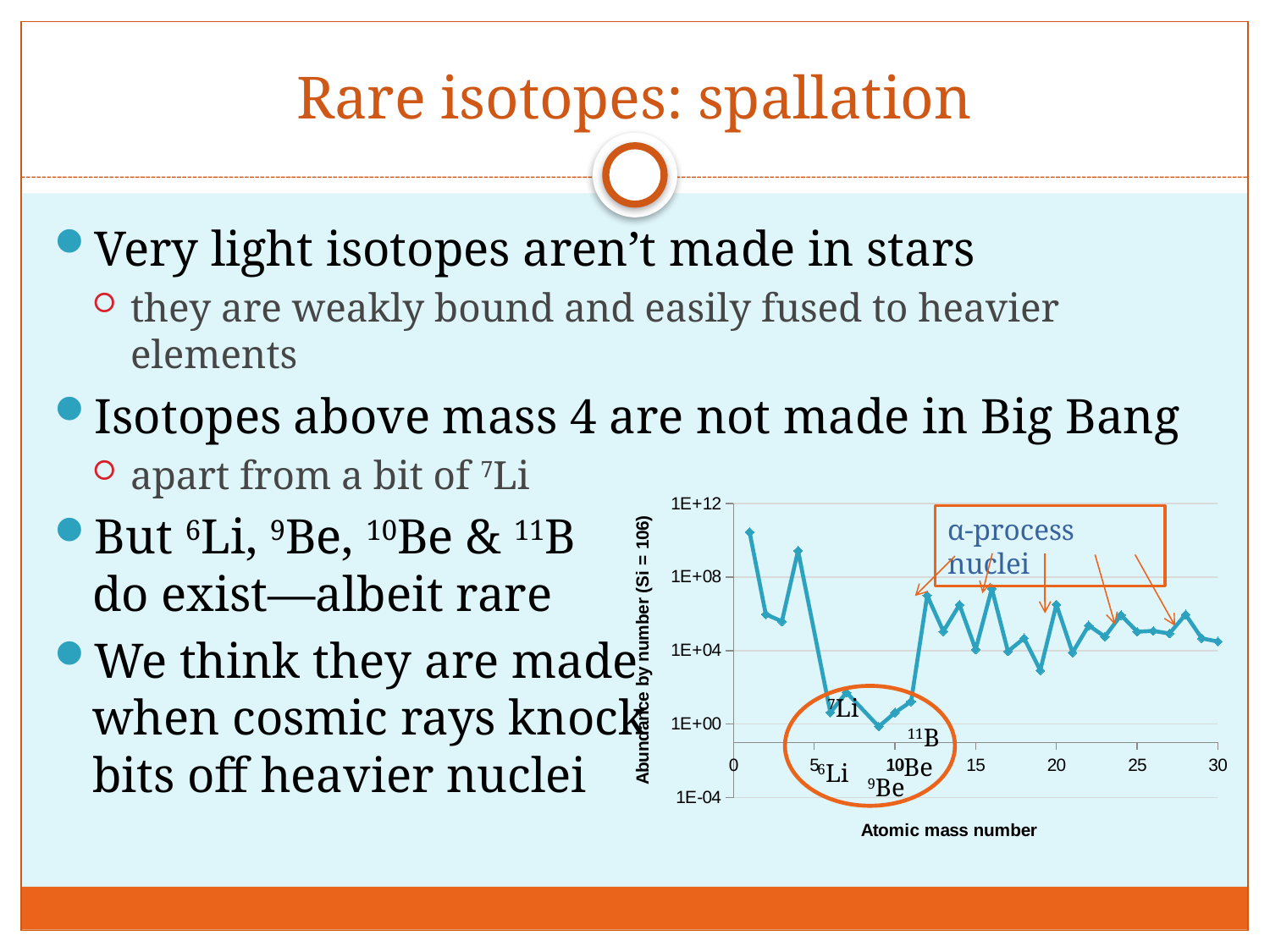
What is the title of the x axis of the chart? Atomic mass number What kind of chart is shown on the slide? line chart Which atomic mass number has the highest abundance in the chart? 1 Is the abundance at atomic mass number 9 greater or less than 1E+04? less Is the abundance at atomic mass number 1 greater or less than 1E+08? greater Which atomic mass number has the lowest abundance in the chart? 9 Is the abundance at atomic mass number 30 greater or less than 1E+08? less What label is written in the orange box at the top right of the chart? α-process nuclei Which has the higher abundance, atomic mass number 4 or atomic mass number 2? 4 Which has the higher abundance, atomic mass number 12 or atomic mass number 9? 12 Do the abundances rise or fall from atomic mass number 4 to atomic mass number 9? fall